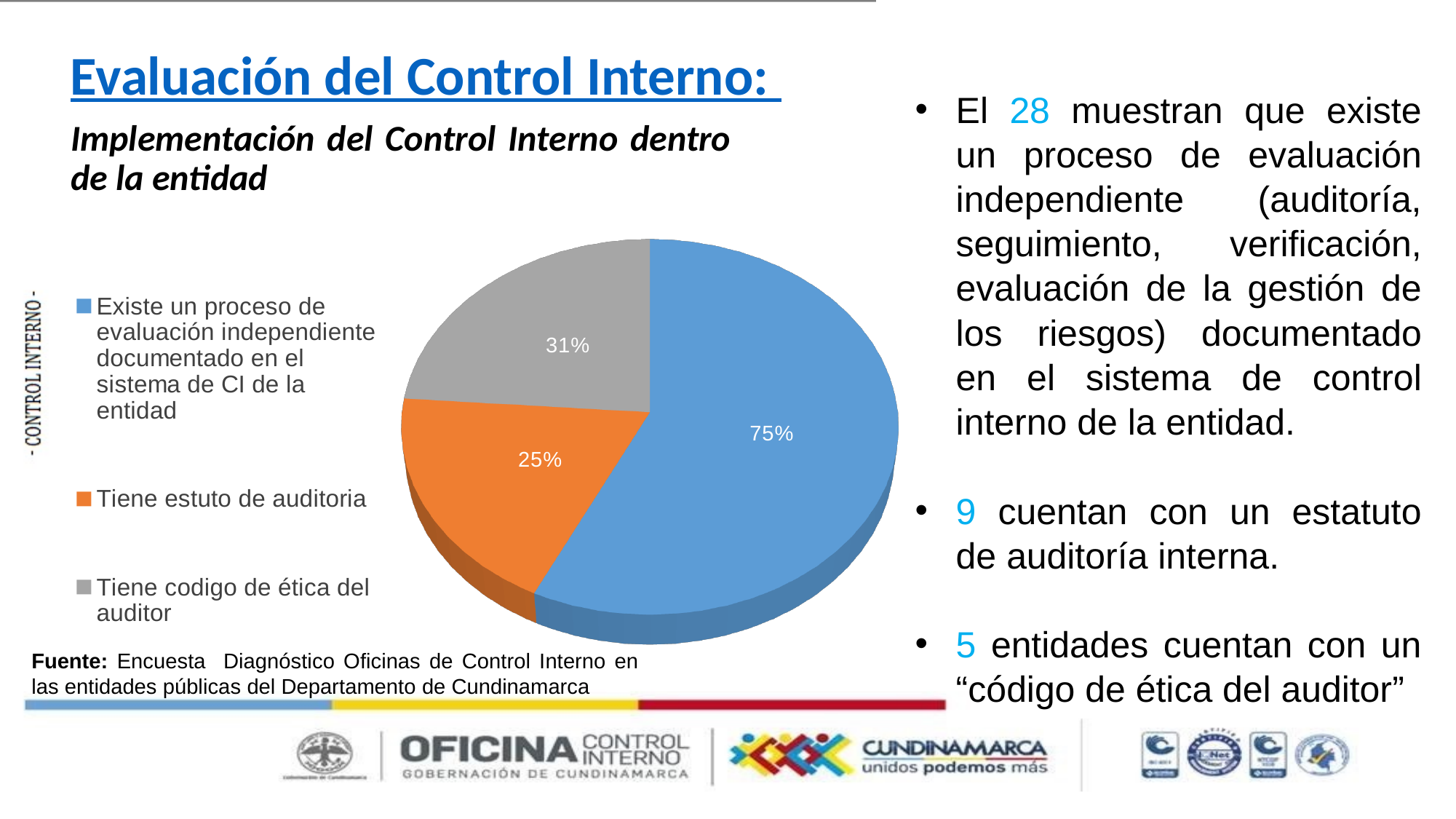
What percentage is shown for the slice 'Tiene estuto de auditoria'? 25% What colour is the slice labelled 'Tiene estuto de auditoria'? orange Which slice of the pie chart is the smallest? Tiene estuto de auditoria Which slice of the pie chart is the largest? Existe un proceso de evaluación independiente documentado en el sistema de CI de la entidad What is the difference between the percentage for 'Existe un proceso de evaluación independiente documentado en el sistema de CI de la entidad' and the percentage for 'Tiene estuto de auditoria'? 50% What is the difference between the percentage for 'Tiene codigo de ética del auditor' and the percentage for 'Tiene estuto de auditoria'? 6% What kind of chart is shown on the slide? pie chart Which is larger: the slice for 'Tiene codigo de ética del auditor' or the slice for 'Tiene estuto de auditoria'? Tiene codigo de ética del auditor What percentage is shown for the slice 'Tiene codigo de ética del auditor'? 31% What percentage is shown for the slice 'Existe un proceso de evaluación independiente documentado en el sistema de CI de la entidad'? 75% What colour is the slice labelled 'Tiene codigo de ética del auditor'? gray How many slices does the pie chart have? 3